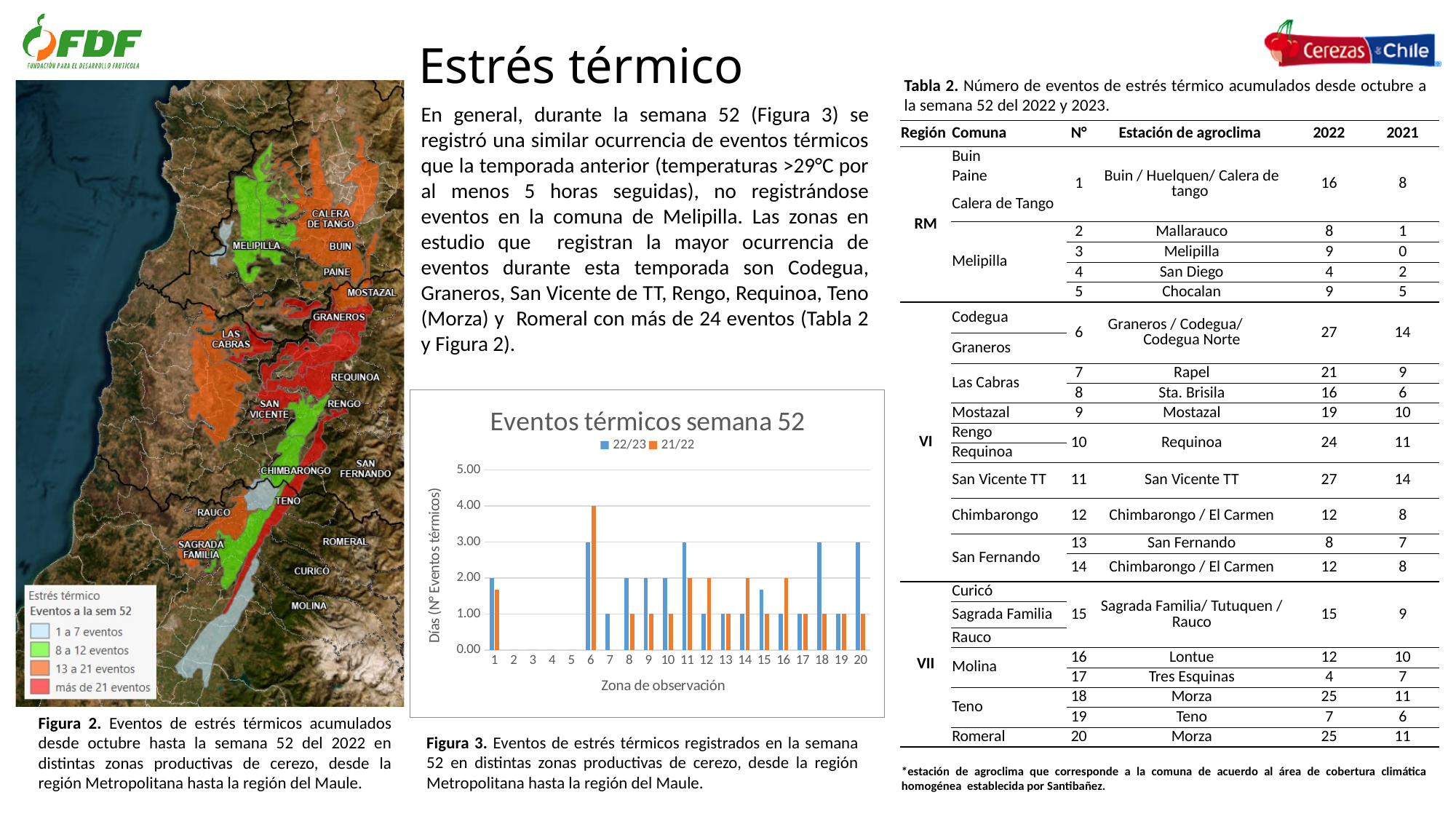
In the 'Eventos térmicos semana 52' chart, what is the 21/22 value for zone 6? 4.00 How many observation zones are shown on the x axis of the 'Eventos térmicos semana 52' chart? 20 In the 'Eventos térmicos semana 52' chart, is the 21/22 value for zone 1 greater or less than 2.00? less In the 'Eventos térmicos semana 52' chart, is the 22/23 value for zone 15 greater or less than 1.00? greater What are the two series named in the legend of the 'Eventos térmicos semana 52' chart? 22/23 and 21/22 In the 'Eventos térmicos semana 52' chart, which series has the larger value for zone 18, 22/23 or 21/22? 22/23 How many series does the legend of the 'Eventos térmicos semana 52' chart list? 2 In the 'Eventos térmicos semana 52' chart, which series has the larger value for zone 6, 22/23 or 21/22? 21/22 In the 'Eventos térmicos semana 52' chart, what is the difference between the 21/22 and 22/23 values for zone 6? 1.00 In the 'Eventos térmicos semana 52' chart, which observation zone has the highest value for the 21/22 series? 6 In the 'Eventos térmicos semana 52' chart, what is the 22/23 value for zone 11? 3.00 What kind of chart is 'Eventos térmicos semana 52'? bar chart